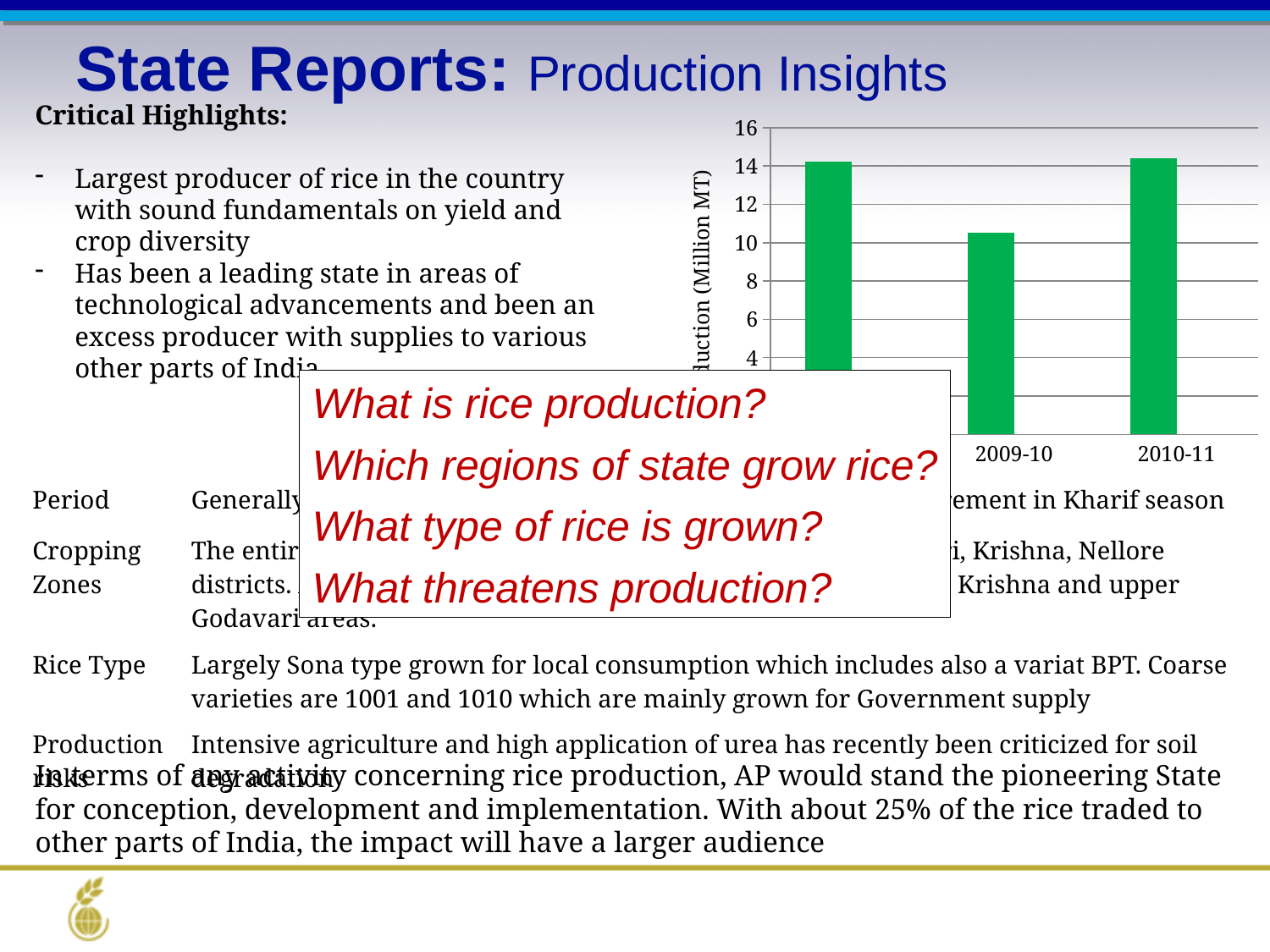
What colour are the bars in the chart? green Does production rise or fall from 2009-10 to 2010-11? rise How many bars does the chart show? 3 What unit is shown on the chart's vertical axis label? Million MT Which labelled year has the lowest production in the chart? 2009-10 Is the value for 2010-11 greater or less than 12? greater Which is larger, the value for 2009-10 or the value for 2010-11? 2010-11 Is the value for 2009-10 greater or less than 12? less What kind of chart is shown on the slide? bar chart Is the value for 2009-10 greater or less than 10? greater